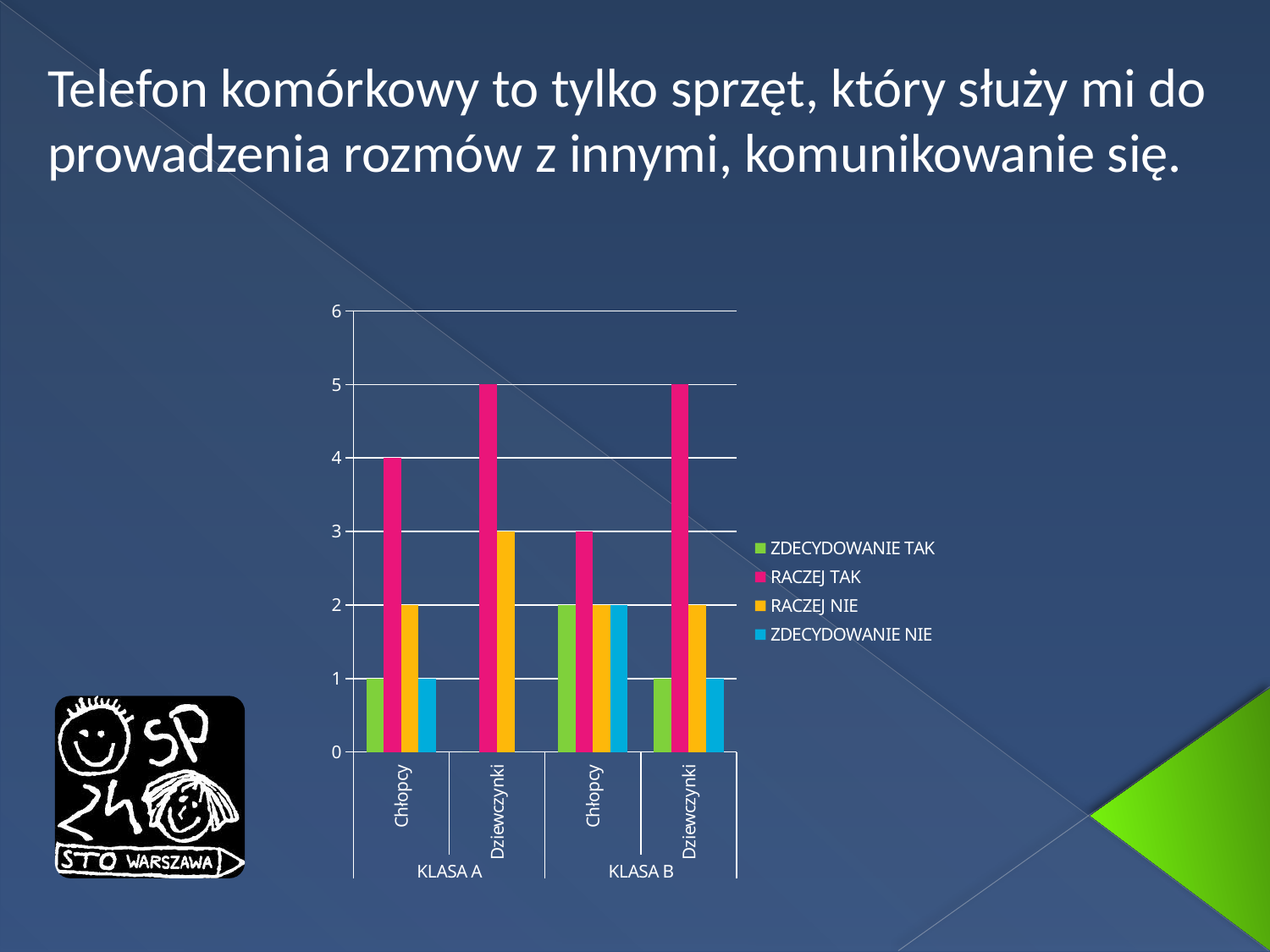
Is the value of RACZEJ TAK for Chłopcy in KLASA B greater or less than 4? less What is the value of RACZEJ TAK for Chłopcy in KLASA A? 4 Which is larger: RACZEJ NIE for Dziewczynki in KLASA A or RACZEJ NIE for Chłopcy in KLASA B? RACZEJ NIE for Dziewczynki in KLASA A What is the value of RACZEJ TAK for Dziewczynki in KLASA B? 5 What is the difference between RACZEJ TAK for Dziewczynki in KLASA A and RACZEJ TAK for Chłopcy in KLASA A? 1 Which series has the highest value for Chłopcy in KLASA A? RACZEJ TAK What is the value of ZDECYDOWANIE TAK for Chłopcy in KLASA B? 2 How many category groups (Chłopcy/Dziewczynki) are shown on the x axis? 4 What is the value of RACZEJ NIE for Dziewczynki in KLASA A? 3 What kind of chart is shown on the slide? bar chart How many series does the legend list? 4 What colour represents the RACZEJ TAK series in the legend? pink